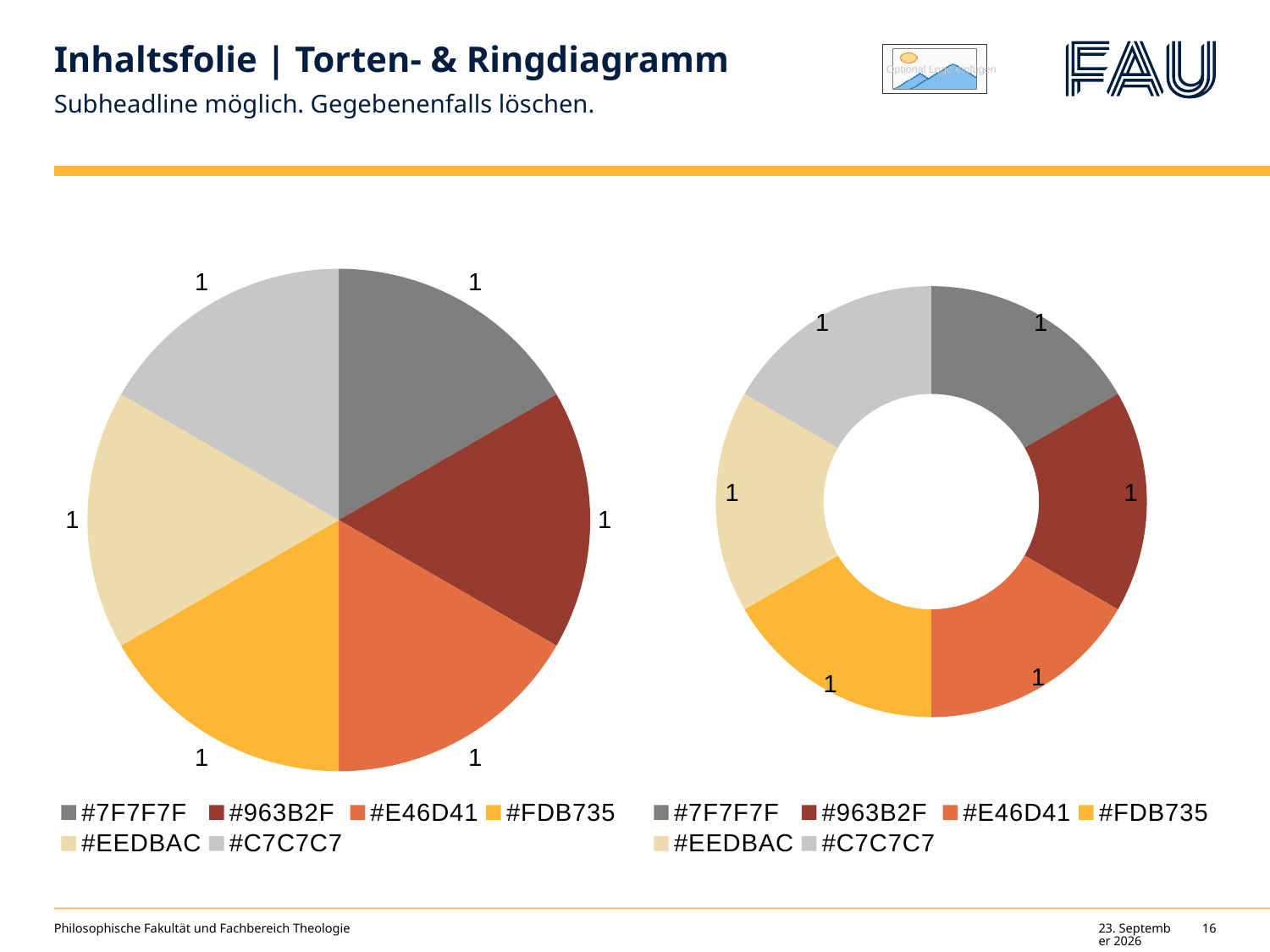
In the pie chart on the left, how many slices are there? 6 What kind of chart is the chart on the left side of the slide? pie chart In the doughnut chart on the right, how many segments are there? 6 In the pie chart on the left, what is the total of all slice values? 6 In the doughnut chart on the right, what is the value of the #EEDBAC segment? 1 In the doughnut chart on the right, what is the value of the #FDB735 segment? 1 In the pie chart on the left, what is the value of the #C7C7C7 slice? 1 What kind of chart is the chart on the right side of the slide? doughnut chart In the pie chart on the left, what is the difference between the #7F7F7F slice and the #E46D41 slice? 0 How many entries does the legend of the doughnut chart on the right list? 6 In the pie chart on the left, what is the value of the #963B2F slice? 1 In the pie chart on the left, which legend entry is shown in the darkest grey colour? #7F7F7F